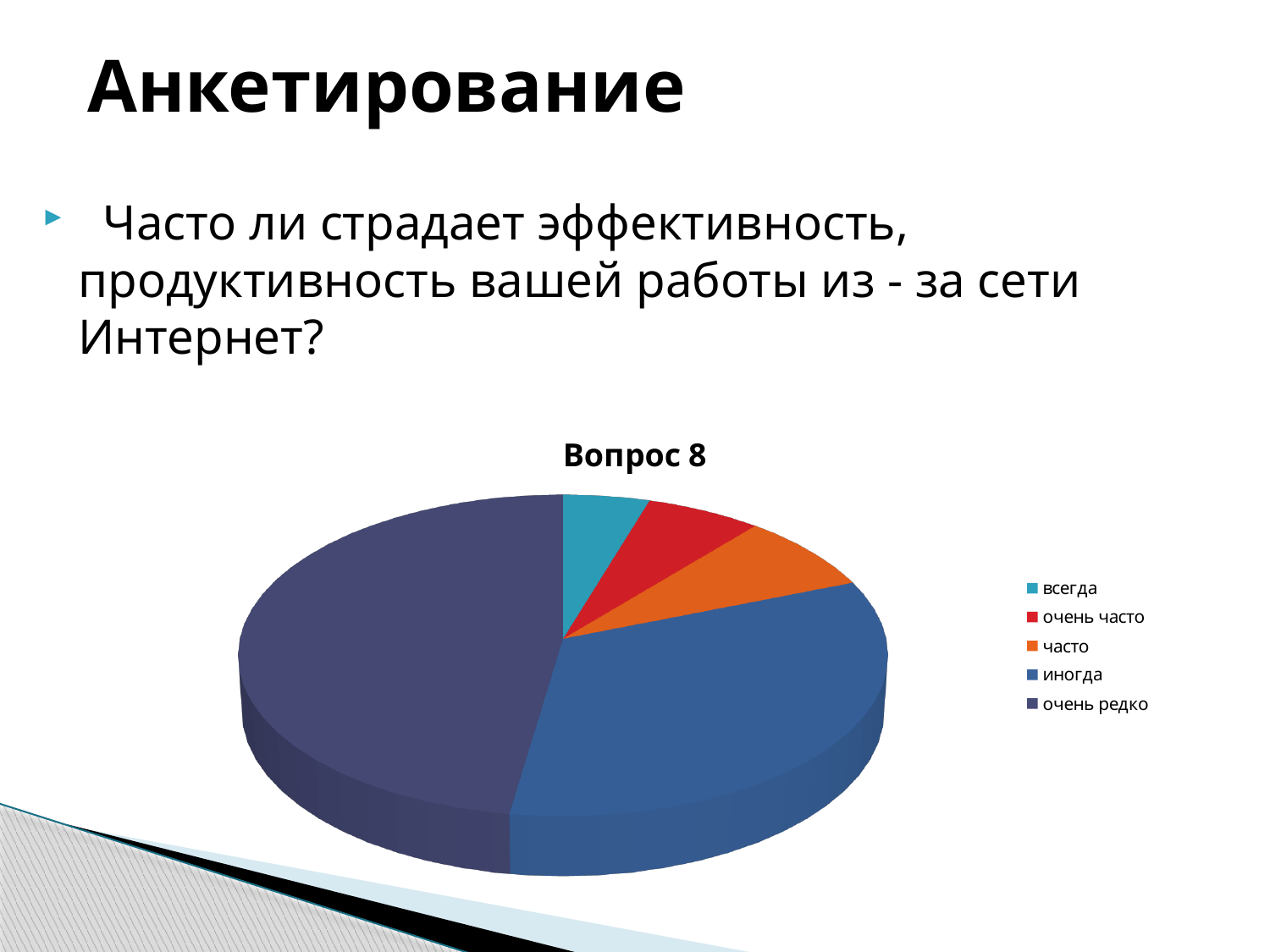
Which slice is larger, очень редко or иногда? очень редко Which category has the largest slice of the pie? очень редко Which legend entry is shown in red? очень часто How many categories does the pie chart have? 5 What is the title of the chart? Вопрос 8 How many entries does the legend list? 5 Which slice is larger, иногда or часто? иногда Which slice is larger, всегда or иногда? иногда What kind of chart is shown on the slide? pie chart